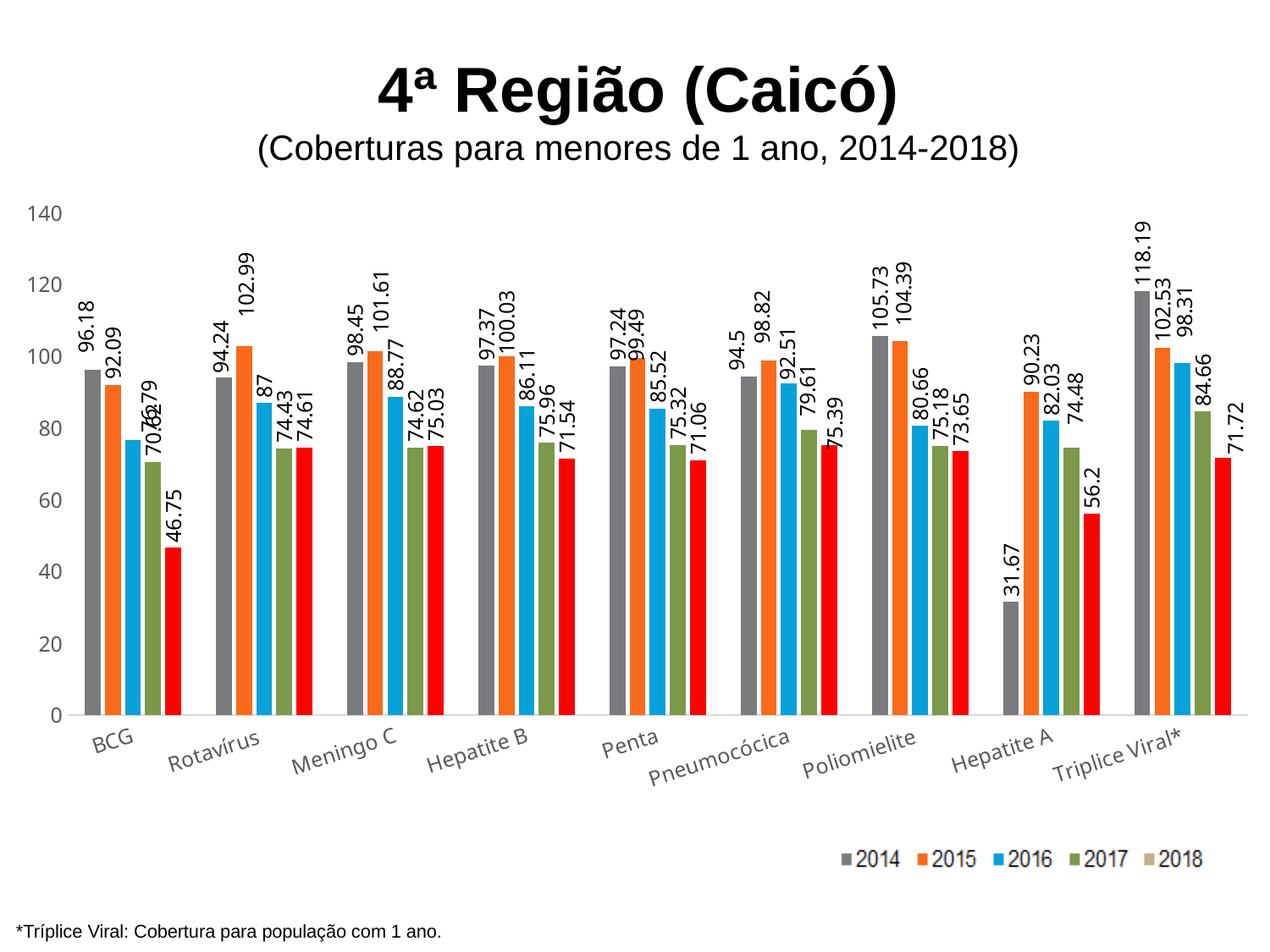
Do the values for Triplice Viral* rise or fall from 2014 to 2018? Fall How many vaccine categories are shown on the x axis? 9 What is the value for Triplice Viral* in 2014? 118.19 Which vaccine has the highest value in the 2014 series? Triplice Viral* What is the difference between the 2018 and 2014 values for Hepatite A? 24.53 What is the difference between the 2014 and 2015 values for Poliomielite? 1.34 How many series does the legend list? 5 What is the value for Hepatite A in 2014? 31.67 Which vaccine has the lowest value in the 2014 series? Hepatite A What is the value for BCG in 2018? 46.75 What kind of chart is shown on the slide? Bar chart Which is larger, the 2015 value for Rotavírus or the 2015 value for Meningo C? Rotavírus